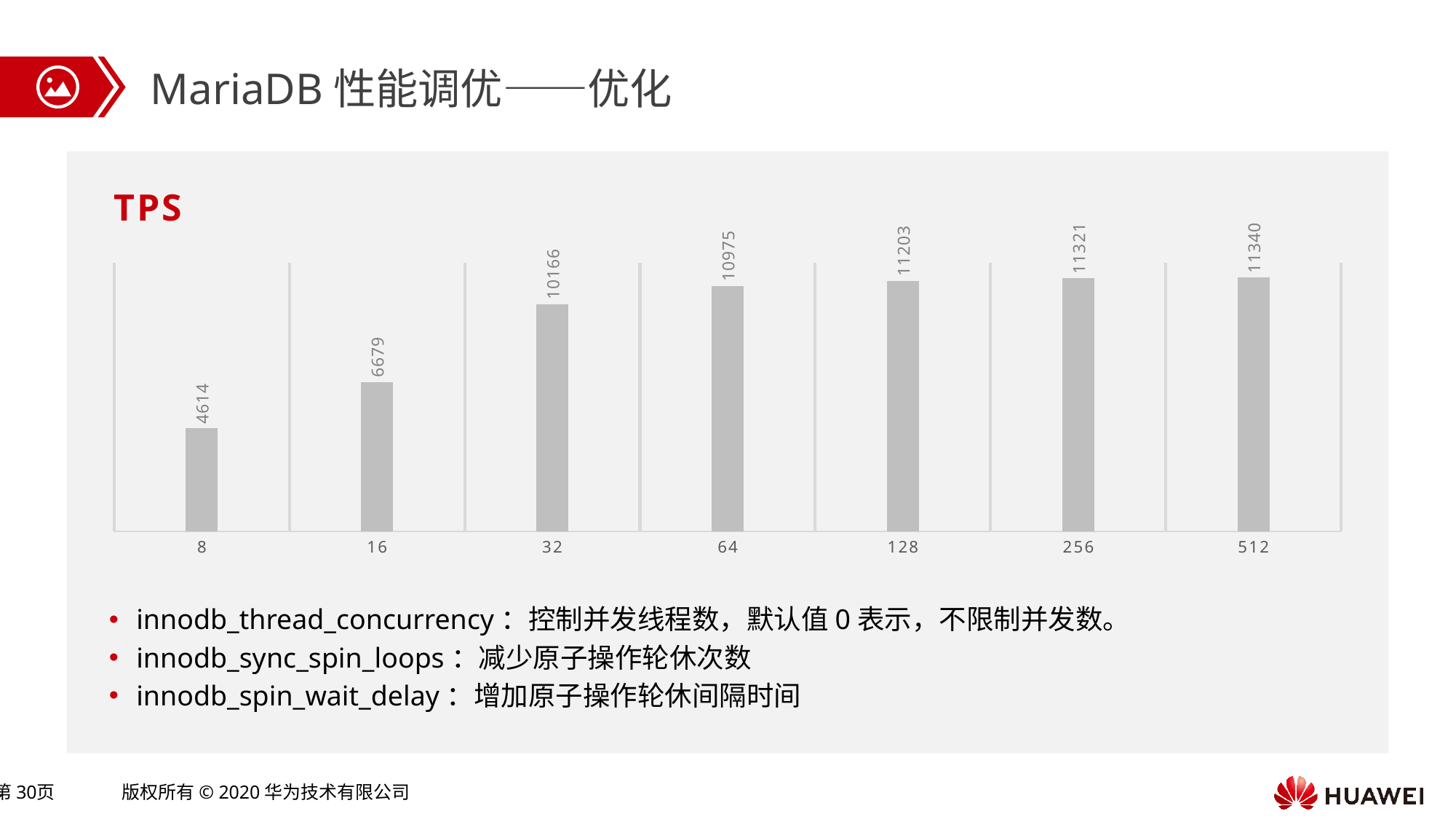
Which category has the lowest TPS value? 8 What kind of chart is shown on the slide? bar chart What is the difference in TPS between category 32 and category 16? 3487 Do the TPS values rise or fall as the categories increase from 8 to 512? rise Which has a larger TPS value, category 32 or category 128? 128 What is the TPS value for category 64? 10975 What is the title of the chart? TPS Which category has the highest TPS value? 512 What is the difference in TPS between category 16 and category 8? 2065 What is the TPS value for category 512? 11340 How many categories are shown on the x axis of the TPS chart? 7 What is the TPS value for category 8? 4614